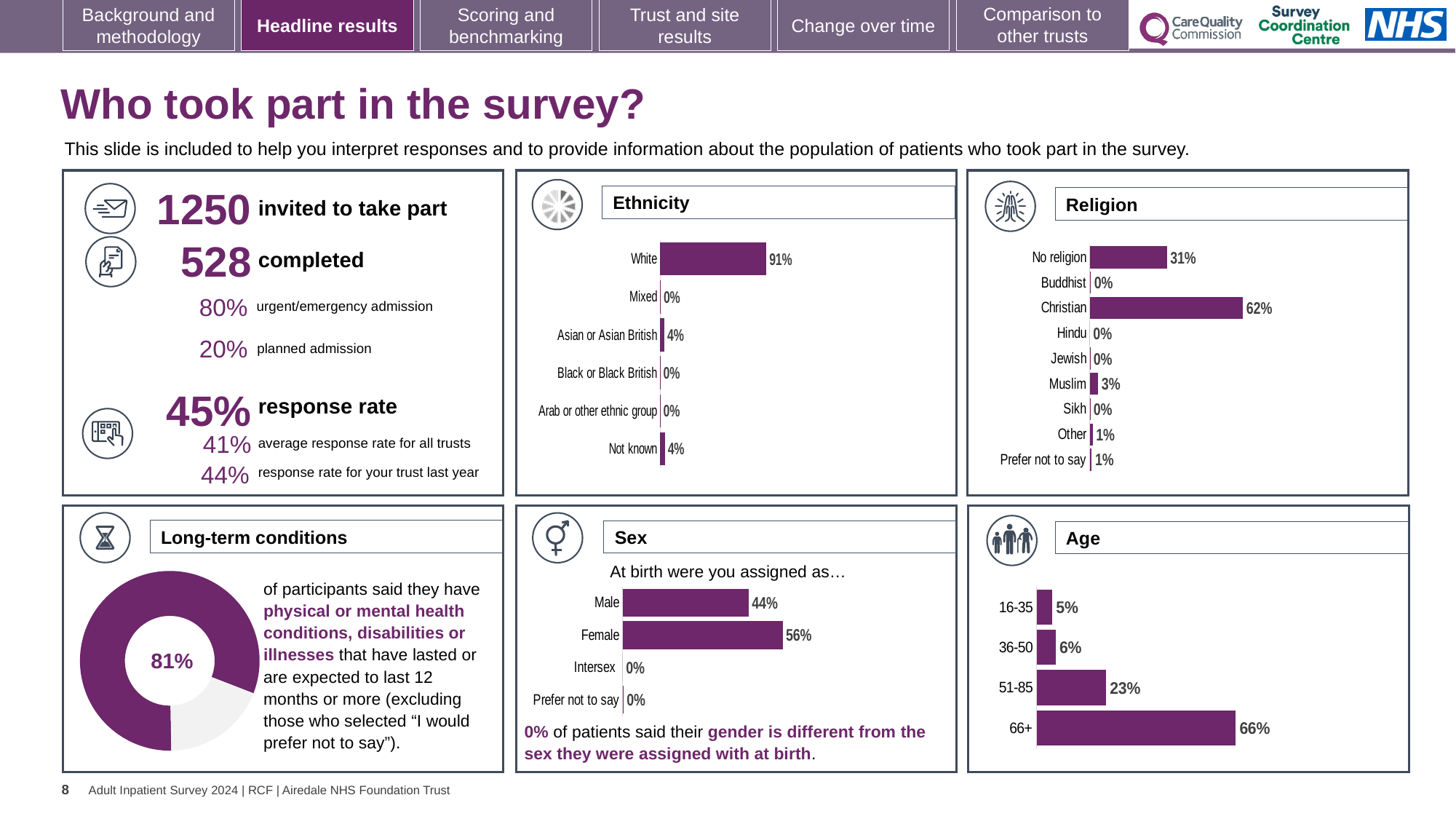
What kind of chart is the Long-term conditions chart? doughnut chart In the Ethnicity chart, which category has the highest value? White In the Age chart, which age group has the highest value? 66+ In the Religion chart, what is the difference between Christian and No religion? 31% In the Religion chart, what is the value for Christian? 62% In the Ethnicity chart, how many categories are shown? 6 In the Age chart, do the values rise or fall as the age groups increase? rise In the Sex chart, what is the value for Male? 44% In the Age chart, what is the value for 51-85? 23% In the Religion chart, how many categories are shown? 9 In the Sex chart, which is larger, Male or Female? Female In the Ethnicity chart, what is the value for White? 91%